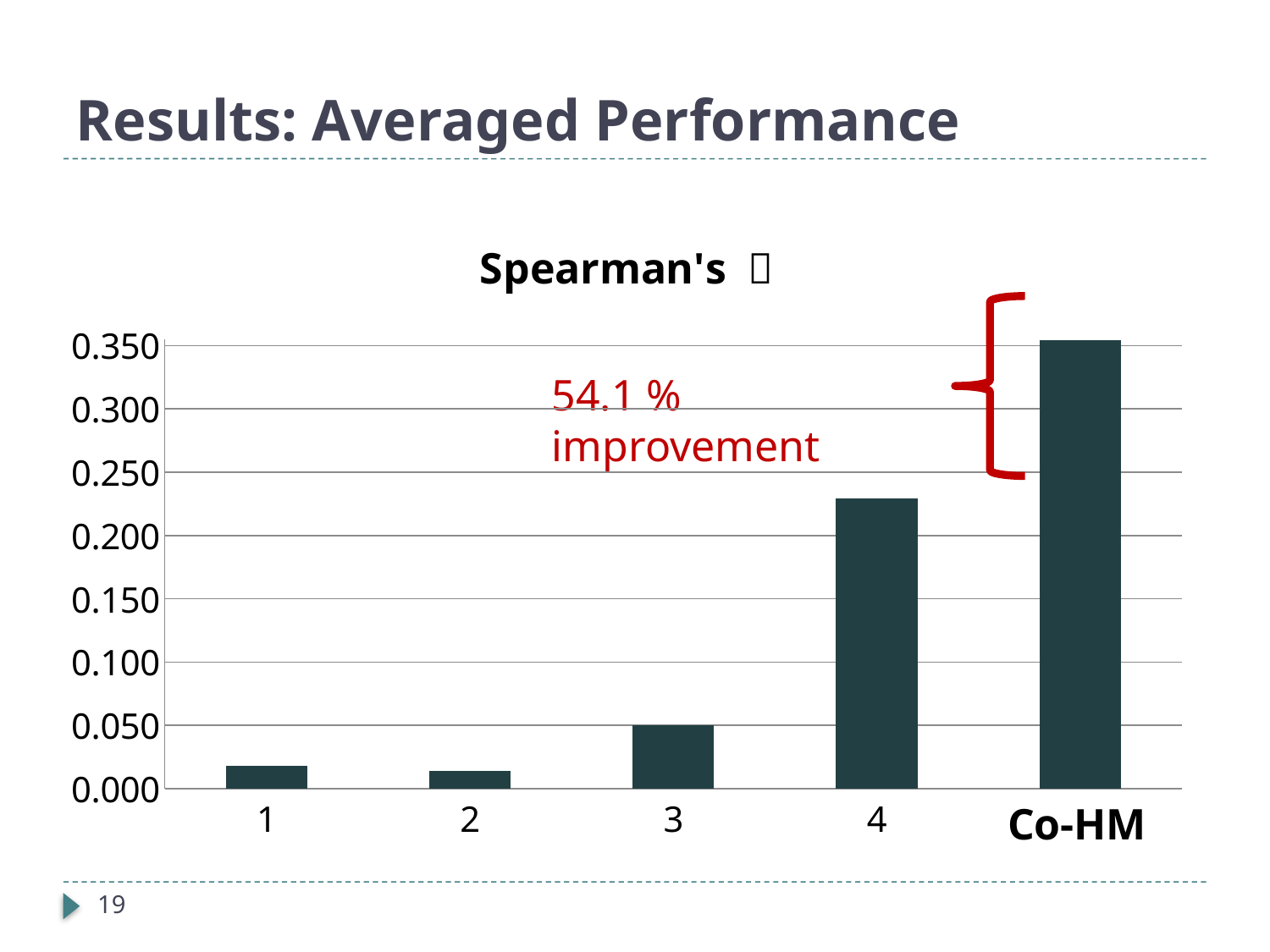
Which has the larger value, category 3 or category 4? 4 Is the value for category 4 greater or less than 0.250? less What percentage improvement is annotated in red on the chart? 54.1 % Is the value for Co-HM greater or less than 0.300? greater Which has the larger value, category 4 or Co-HM? Co-HM What kind of chart is shown on the slide? bar chart Is the value for category 4 greater or less than 0.200? greater What is the label of the rightmost bar on the x axis? Co-HM Which category has the highest value in the chart? Co-HM How many bars (categories) are plotted in the chart? 5